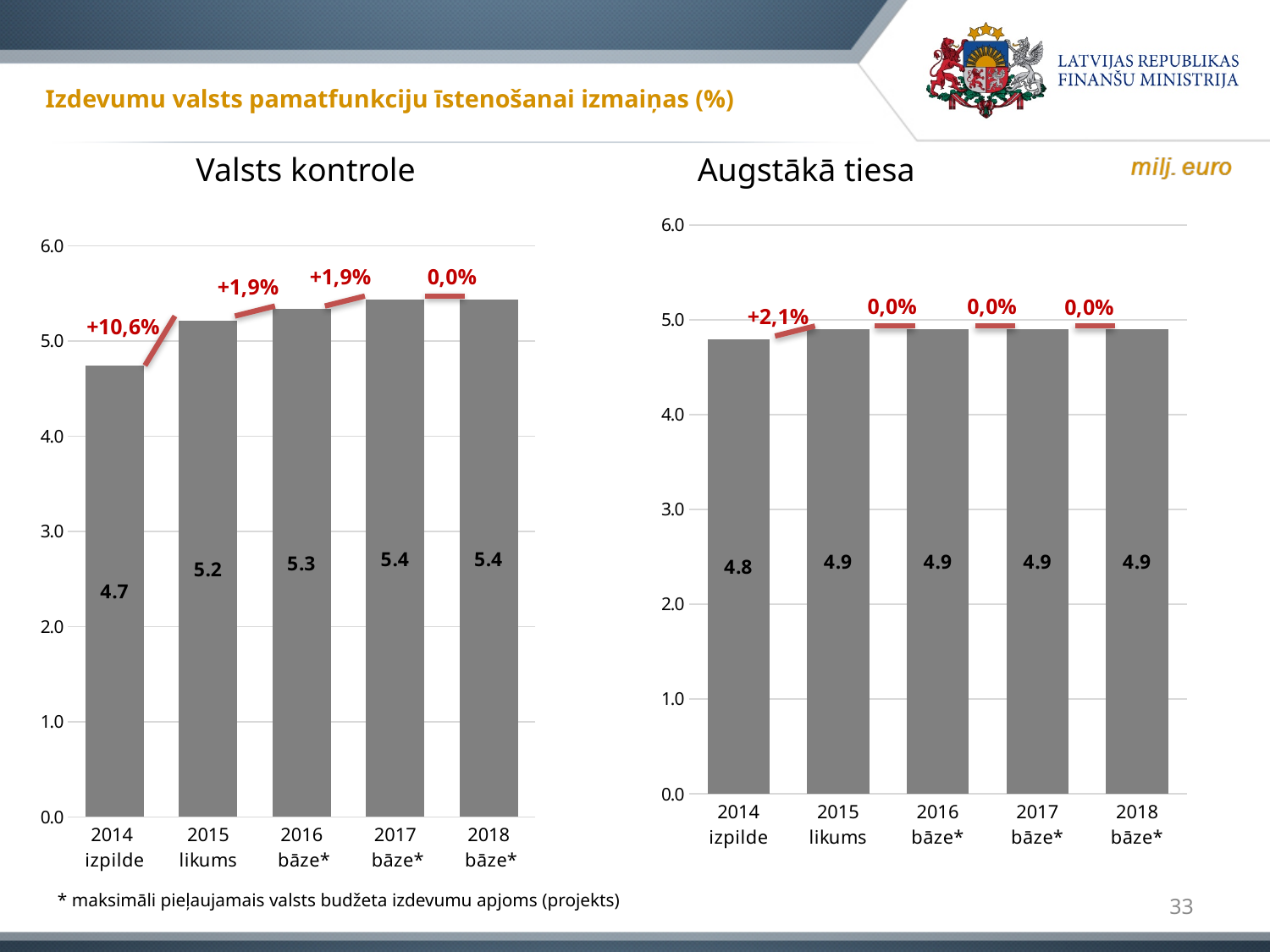
In the 'Valsts kontrole' chart, what is the value for 2016 bāze*? 5.3 In the 'Valsts kontrole' chart, which is larger: the value for 2015 likums or the value for 2017 bāze*? 2017 bāze* In the 'Augstākā tiesa' chart, is the value for 2014 izpilde greater or less than 5.0? less In the 'Valsts kontrole' chart, do the values rise or fall from 2014 izpilde to 2017 bāze*? rise In the 'Augstākā tiesa' chart, which category has the lowest value? 2014 izpilde In the 'Valsts kontrole' chart, which category has the lowest value? 2014 izpilde In the 'Valsts kontrole' chart, what percentage change is labelled between 2014 izpilde and 2015 likums? +10,6% How many categories are shown in the 'Valsts kontrole' chart? 5 In the 'Valsts kontrole' chart, what is the difference between the 2018 bāze* value and the 2014 izpilde value? 0.7 What kind of chart is the 'Augstākā tiesa' chart? bar chart In the 'Valsts kontrole' chart, what is the value for 2014 izpilde? 4.7 In the 'Augstākā tiesa' chart, what is the value for 2014 izpilde? 4.8